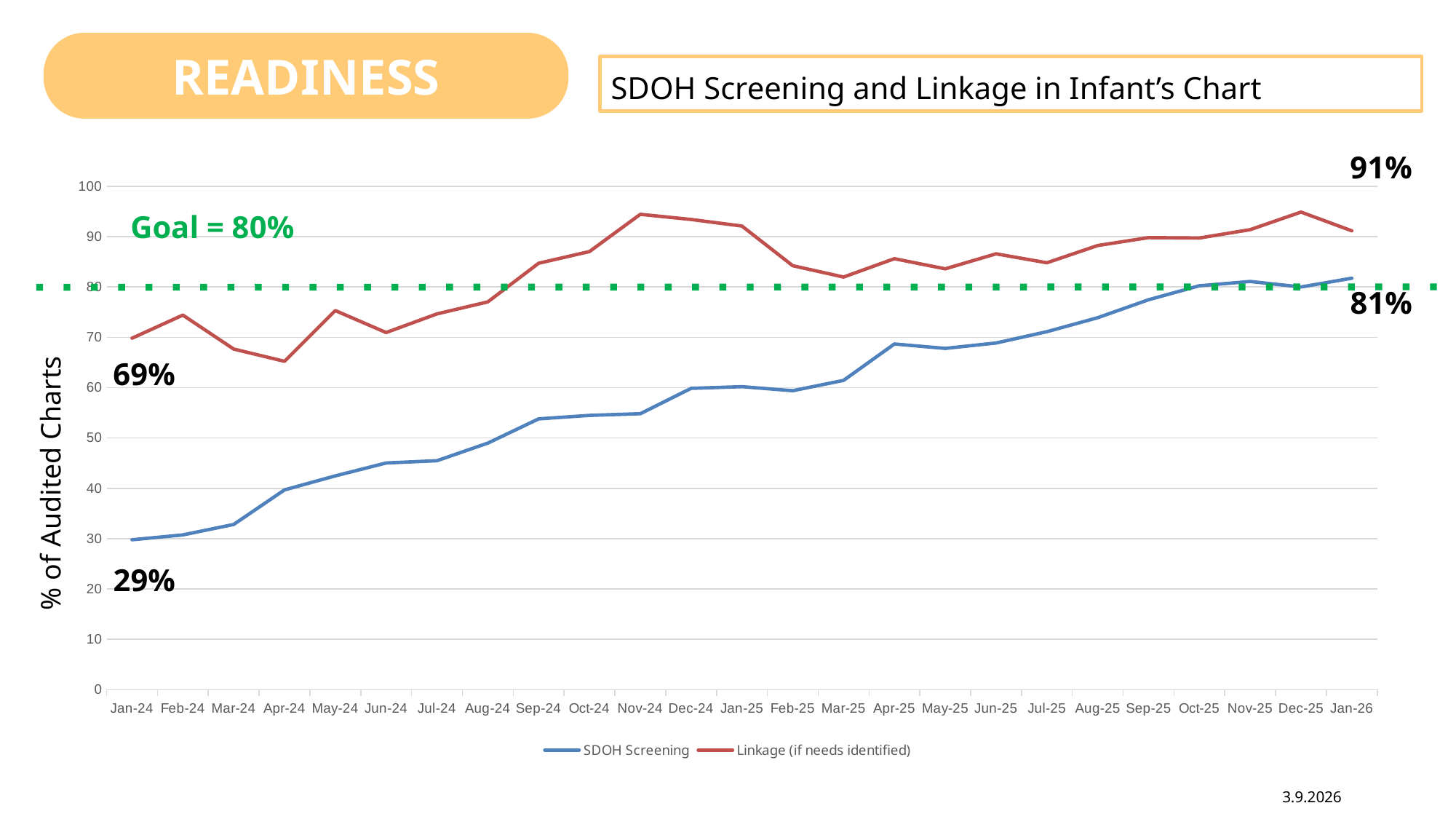
How many series does the legend list? 2 What goal value is marked by the dotted green line? 80% What is the SDOH Screening value for Jan-26? 81% Which series is higher in Jan-24, SDOH Screening or Linkage (if needs identified)? Linkage (if needs identified) By how much did SDOH Screening increase from Jan-24 to Jan-26? 52% What is the difference between the Linkage and SDOH Screening values in Jan-26? 10% What is the Linkage (if needs identified) value for Jan-24? 69% Does the SDOH Screening line generally rise or fall from Jan-24 to Jan-26? rise What is the SDOH Screening value for Jan-24? 29% What is the Linkage (if needs identified) value for Jan-26? 91% What kind of chart is shown on the slide? line chart Is the SDOH Screening value for Dec-24 greater or less than 70? less